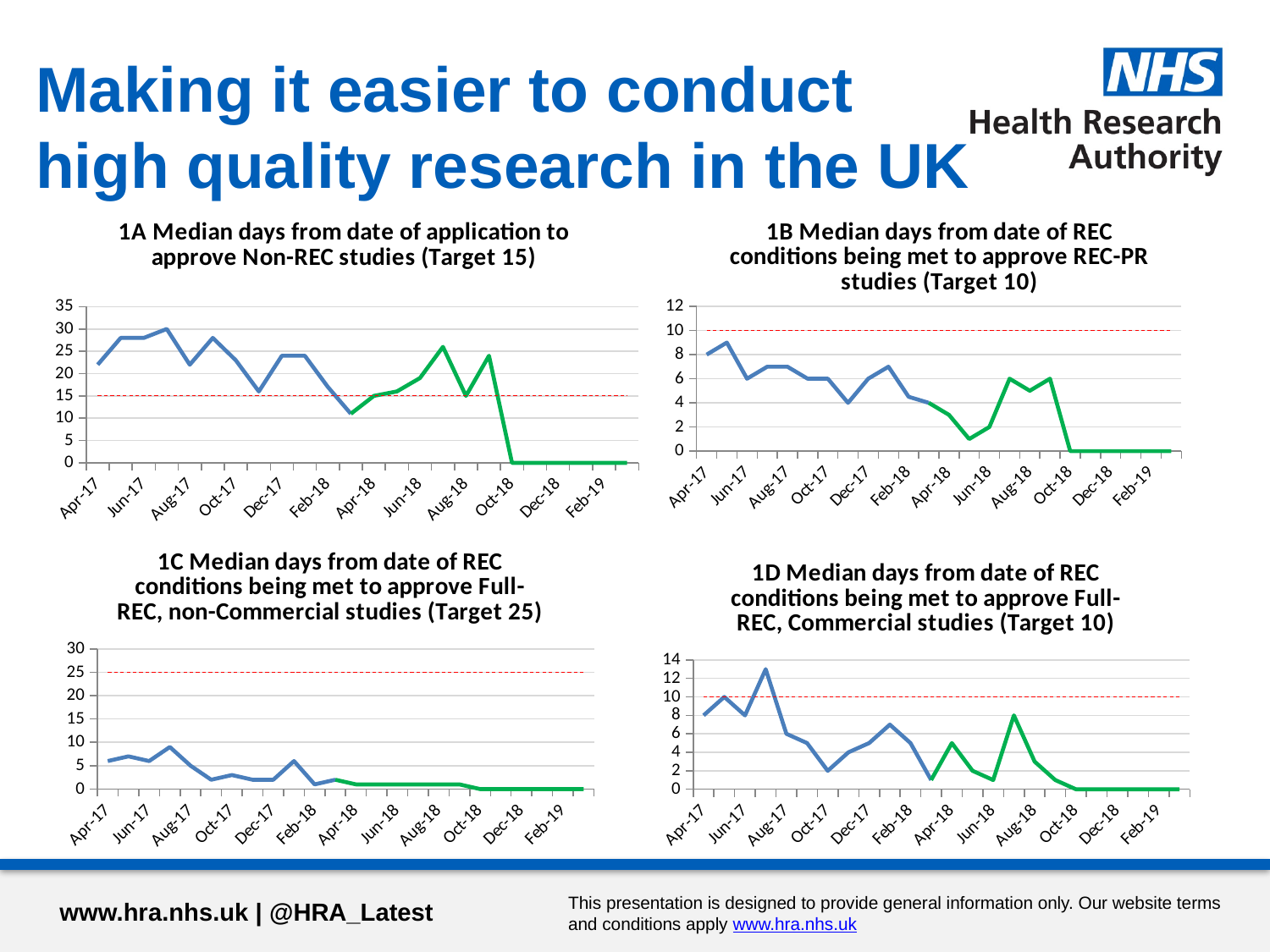
In chart 1B (REC-PR studies), is the value for Apr-17 greater or less than 10? less In chart 1B (REC-PR studies), what is the value for Dec-18? 0 In chart 1D (Full-REC, Commercial studies), is the value for Apr-17 greater or less than 10? less In chart 1D (Full-REC, Commercial studies), is the value for Aug-18 greater or less than 6? less In chart 1A (Non-REC studies), what is the value for Feb-19? 0 In chart 1A (Non-REC studies), which labelled month has the highest median days? Jun-17 In chart 1C (Full-REC, non-Commercial studies), do the values generally rise or fall from Apr-17 to Feb-19? fall What kind of chart is chart 1A (Median days from date of application to approve Non-REC studies)? line chart In chart 1B (REC-PR studies), at what value is the dashed red target line drawn? 10